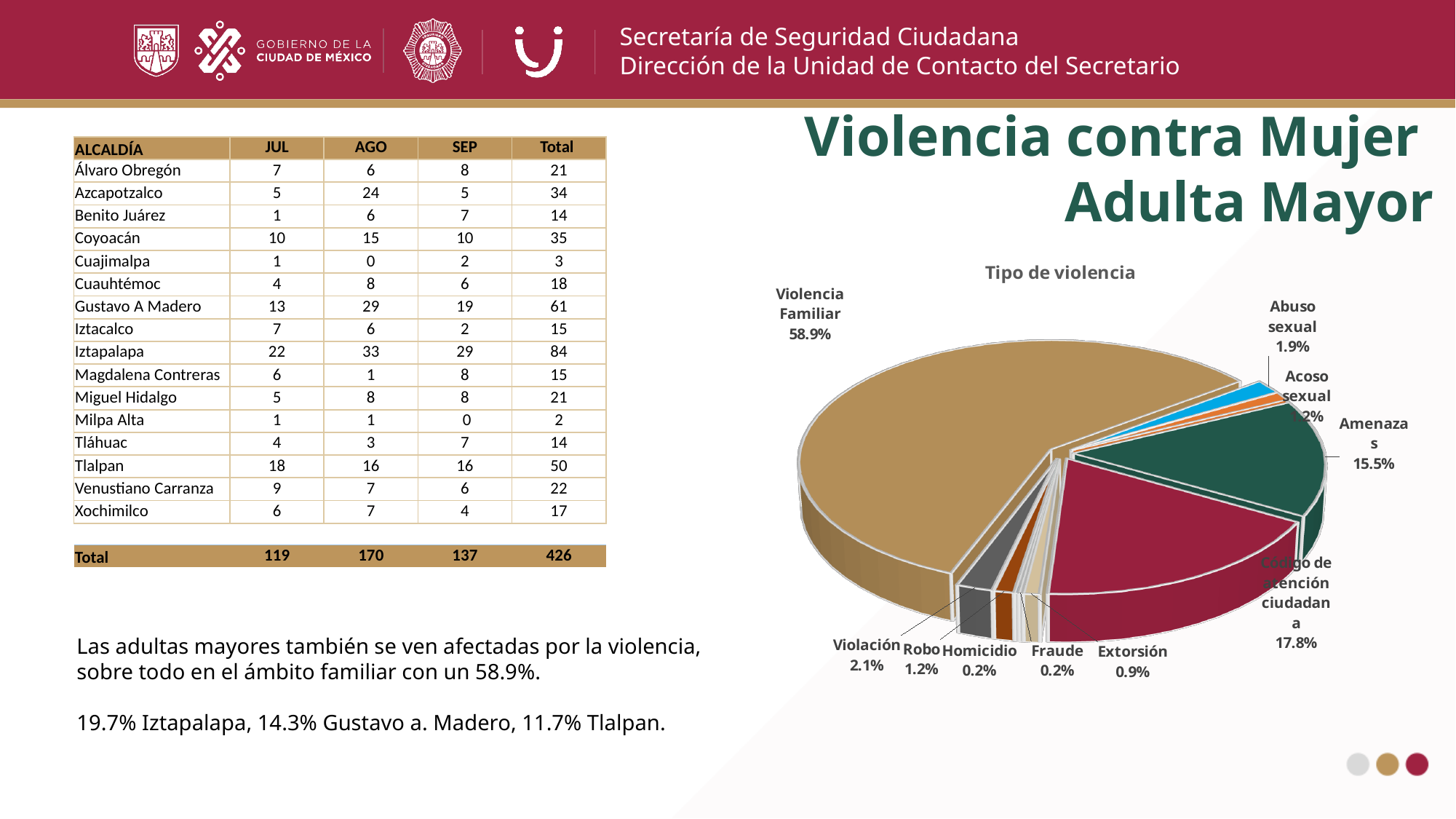
What percentage is shown for Extorsión in the pie chart? 0.9% What percentage is shown for Código de atención ciudadana in the pie chart? 17.8% What percentage is shown for Violación in the pie chart? 2.1% What percentage is shown for Robo in the pie chart? 1.2% What kind of chart is shown under the title "Tipo de violencia"? Pie chart What is the title of the pie chart? Tipo de violencia What percentage is shown for Amenazas in the pie chart? 15.5% Which category has the largest slice in the pie chart? Violencia Familiar Which is larger in the pie chart, Amenazas or Código de atención ciudadana? Código de atención ciudadana What is the difference in percentage points between Violencia Familiar and Amenazas in the pie chart? 43.4 What share of the pie chart does Violencia Familiar represent? 58.9% How many categories are shown in the pie chart? 10